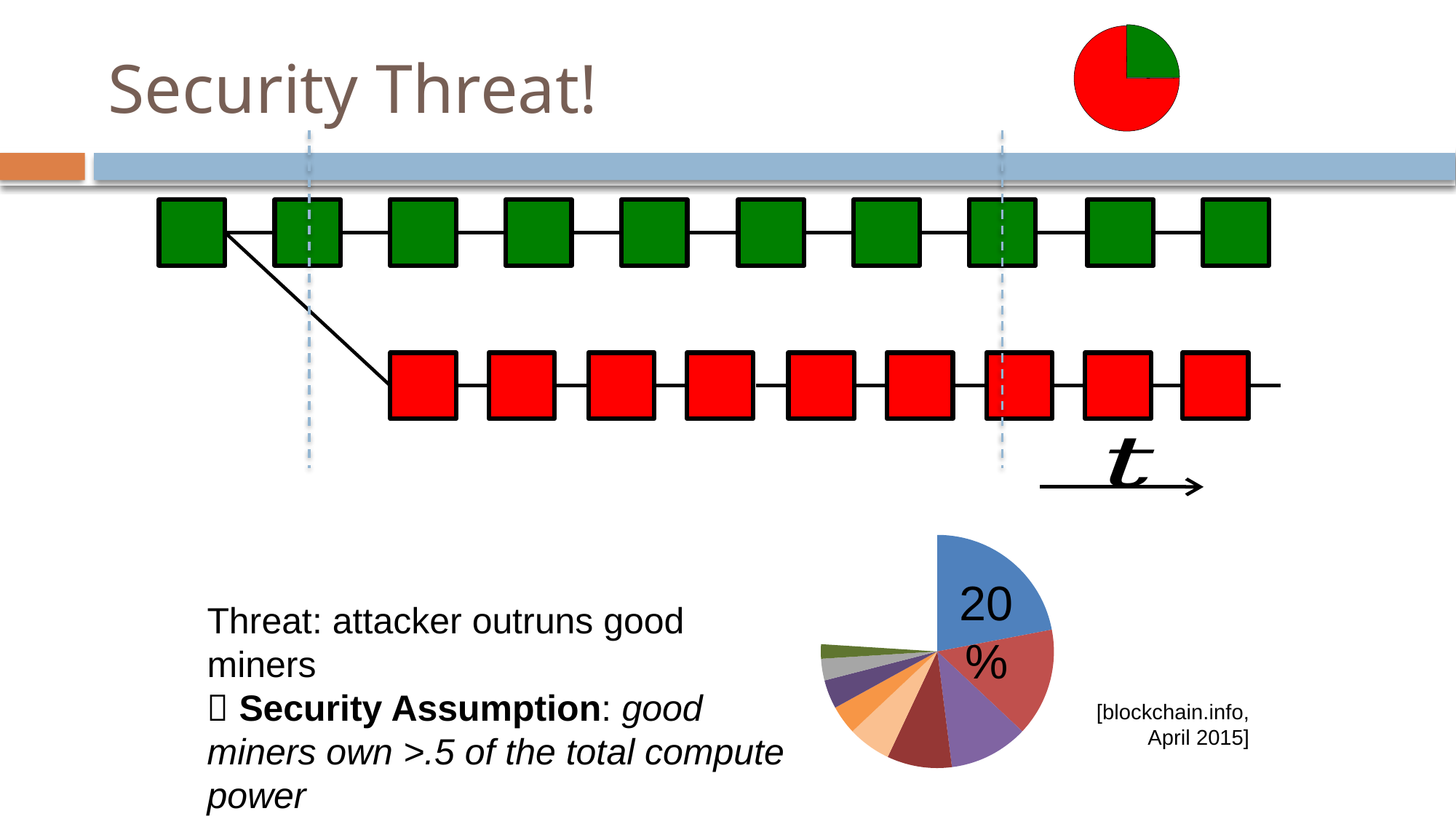
What kind of chart is the chart at the bottom of the slide next to the text? pie chart In the top-right pie chart, is the green slice's share greater or less than half of the pie? less Which two colours make up the top-right pie chart? red and green In the top-right pie chart, which colour covers the larger share, red or green? red In the bottom pie chart, which colour slice is the largest? blue In the bottom pie chart, what value is printed on the blue slice? 20% What source and date are cited next to the bottom pie chart? blockchain.info, April 2015 What kind of chart is the small chart in the top-right corner of the slide? pie chart